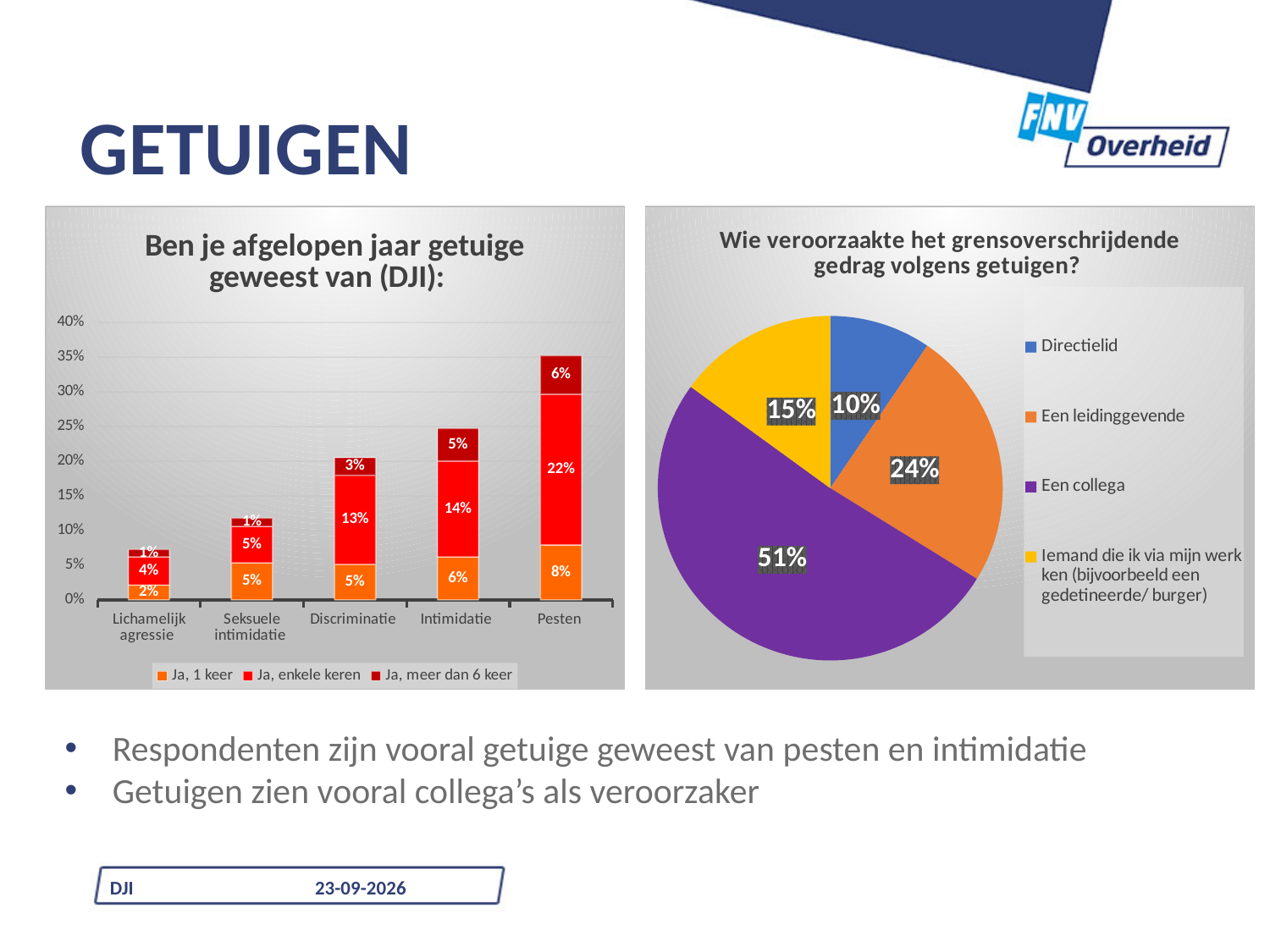
How many categories are shown on the x axis of the chart 'Ben je afgelopen jaar getuige geweest van (DJI):'? 5 In the chart 'Ben je afgelopen jaar getuige geweest van (DJI):', what is the difference between the 'Ja, enkele keren' values for Intimidatie and Discriminatie? 1% What kind of chart is the chart on the right side of the slide? Pie chart How many series does the legend of the chart 'Ben je afgelopen jaar getuige geweest van (DJI):' list? 3 In the chart 'Ben je afgelopen jaar getuige geweest van (DJI):', which category has the shortest stacked bar? Lichamelijk agressie In the chart 'Ben je afgelopen jaar getuige geweest van (DJI):', which category has the tallest stacked bar? Pesten In the chart 'Ben je afgelopen jaar getuige geweest van (DJI):', what is the value of 'Ja, enkele keren' for Pesten? 22% In the pie chart 'Wie veroorzaakte het grensoverschrijdende gedrag volgens getuigen?', what share is 'Een collega'? 51% In the pie chart 'Wie veroorzaakte het grensoverschrijdende gedrag volgens getuigen?', which slice is the smallest? Directielid In the chart 'Ben je afgelopen jaar getuige geweest van (DJI):', what is the total of the stacked bar for Pesten? 36% In the chart 'Ben je afgelopen jaar getuige geweest van (DJI):', what is the value of 'Ja, meer dan 6 keer' for Discriminatie? 3% In the chart 'Ben je afgelopen jaar getuige geweest van (DJI):', what is the value of 'Ja, 1 keer' for Intimidatie? 6%